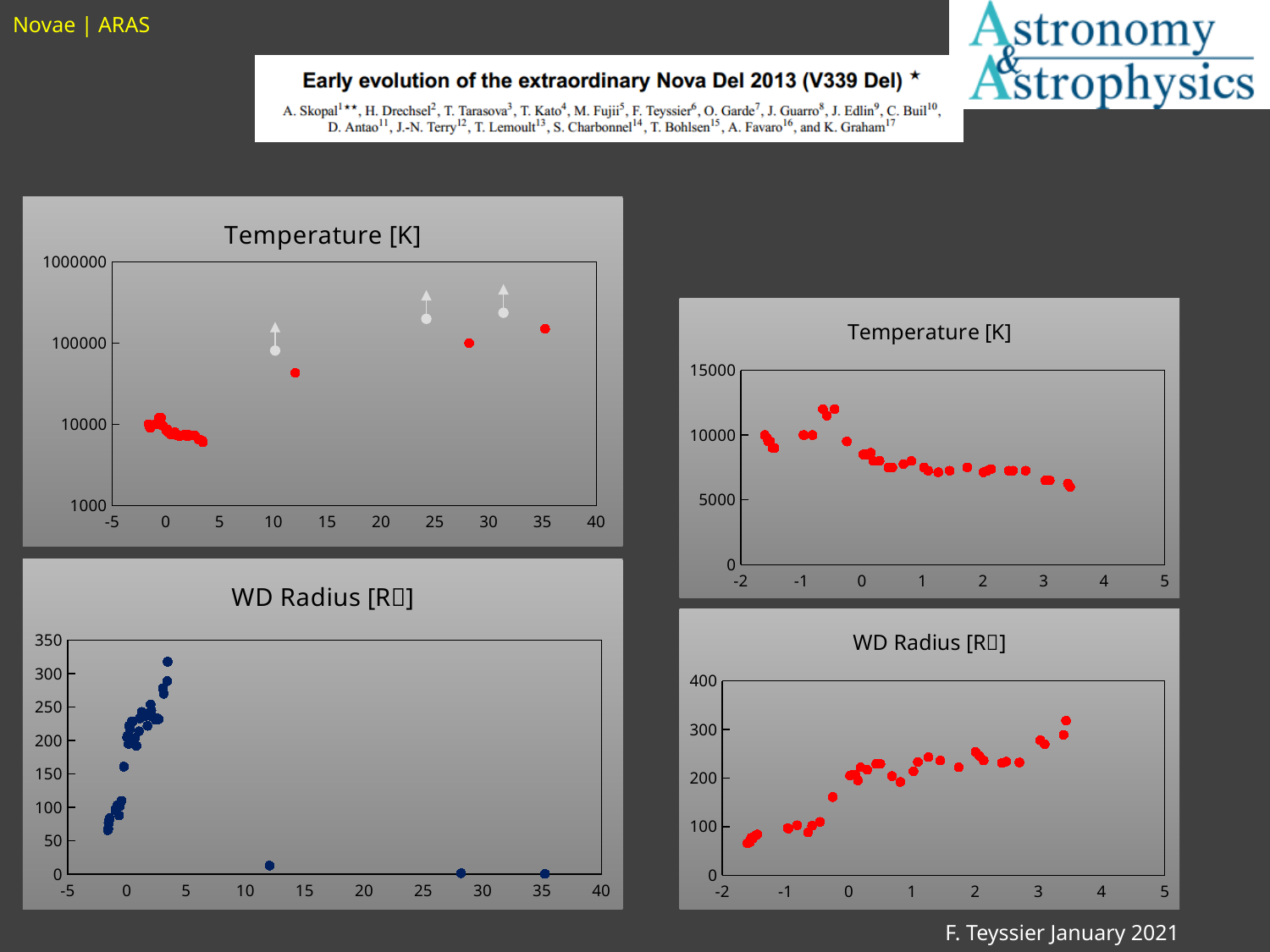
What kind of chart is the top-left Temperature [K] chart? scatter chart In the top-right Temperature [K] chart, is the value of the highest point near x = -0.6 greater or less than 10000? greater In the bottom-right WD Radius chart, is the value of the highest point near x = 3.4 greater or less than 200? greater In the bottom-left WD Radius chart, is the value of the highest point near x = 3.5 greater or less than 250? greater In the top-right Temperature [K] chart, do the values generally rise or fall along the x axis from -2 to 5? fall What is the maximum value shown on the y axis of the bottom-right WD Radius chart? 400 How many charts are shown on the slide? 4 In the bottom-right WD Radius chart, do the values generally rise or fall along the x axis from -2 to 5? rise